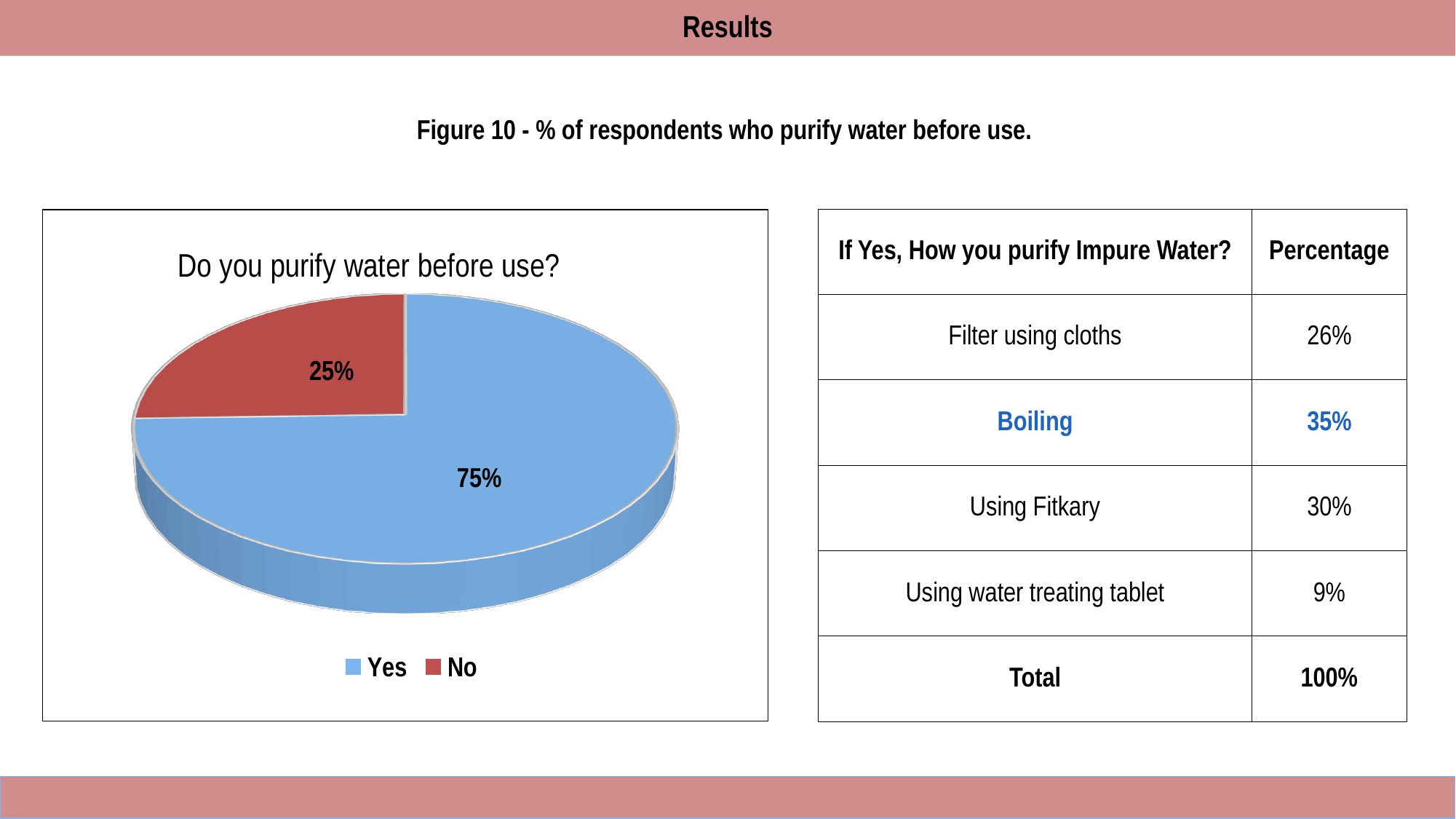
How many slices does the pie chart have? 2 What type of chart is shown on the slide? Pie chart What colour is the No slice? Red What percentage of respondents answered Yes? 75% Which category has the smallest share of the pie? No What share of the pie does the Yes slice represent? 75% Which is larger, the Yes slice or the No slice? Yes What is the chart's title? Do you purify water before use? What is the difference between the Yes and No percentages? 50% What percentage of respondents answered No? 25% Which category has the largest share of the pie? Yes How many entries does the legend list? 2